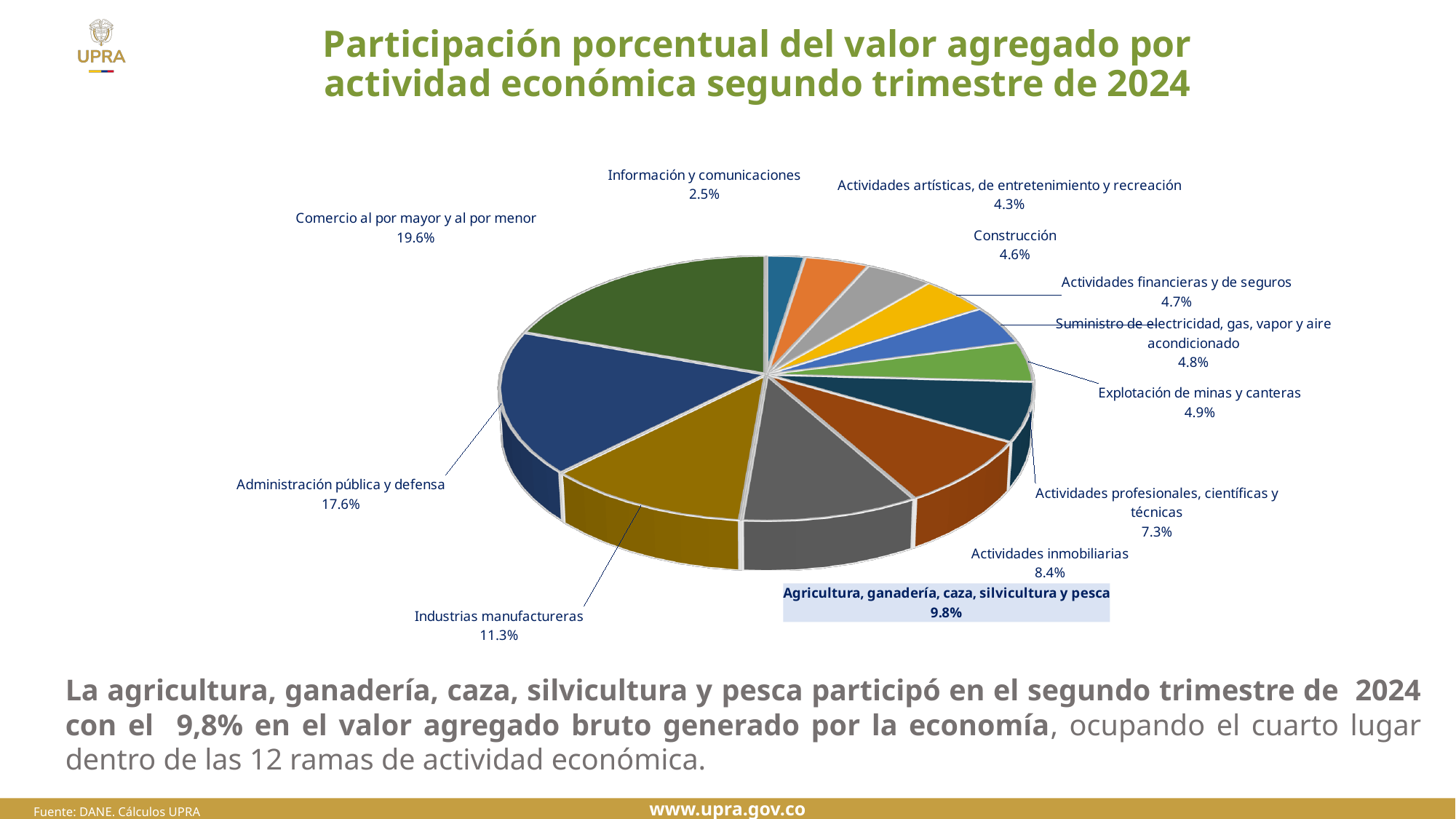
Which activity has the largest share of the pie? Comercio al por mayor y al por menor What is the difference between the shares of Comercio al por mayor y al por menor and Administración pública y defensa? 2.0% How many slices does the pie chart have? 12 What is the value for Comercio al por mayor y al por menor? 19.6% What kind of chart is shown on the slide? Pie chart Which is larger, the share of Actividades inmobiliarias or the share of Actividades profesionales, científicas y técnicas? Actividades inmobiliarias What is the difference between the shares of Industrias manufactureras and Agricultura, ganadería, caza, silvicultura y pesca? 1.5% What is the title of the chart? Participación porcentual del valor agregado por actividad económica segundo trimestre de 2024 What is the value for Suministro de electricidad, gas, vapor y aire acondicionado? 4.8% What is the value for Industrias manufactureras? 11.3% Which activity has the smallest share of the pie? Información y comunicaciones What share of the pie does Agricultura, ganadería, caza, silvicultura y pesca represent? 9.8%